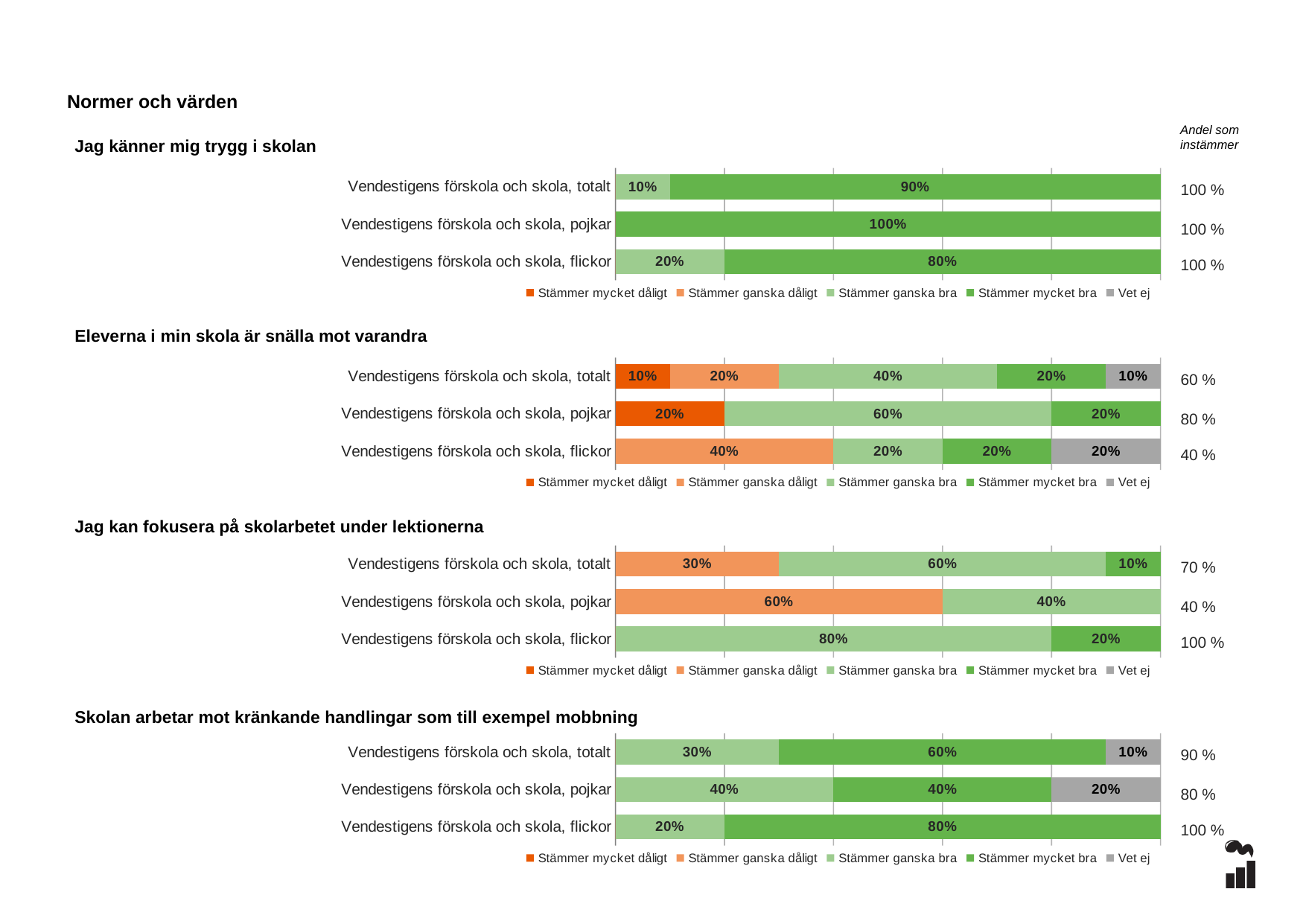
In the chart 'Skolan arbetar mot kränkande handlingar som till exempel mobbning', which is larger: the 'Stämmer mycket bra' value for totalt or for pojkar? totalt In the chart 'Jag kan fokusera på skolarbetet under lektionerna', what is the 'Stämmer ganska dåligt' value for Vendestigens förskola och skola, pojkar? 60% In the chart 'Jag kan fokusera på skolarbetet under lektionerna', what is the difference between the 'Stämmer ganska bra' values for flickor and pojkar? 40% In the chart 'Eleverna i min skola är snälla mot varandra', what is the 'Vet ej' value for Vendestigens förskola och skola, totalt? 10% How many series does the legend list for the chart 'Jag känner mig trygg i skolan'? 5 In the chart 'Eleverna i min skola är snälla mot varandra', which row has the lowest 'Andel som instämmer'? Vendestigens förskola och skola, flickor In the chart 'Jag kan fokusera på skolarbetet under lektionerna', what is the 'Andel som instämmer' for Vendestigens förskola och skola, totalt? 70 % What kind of chart is 'Eleverna i min skola är snälla mot varandra'? Stacked bar chart In the chart 'Jag känner mig trygg i skolan', what is the 'Stämmer mycket bra' value for Vendestigens förskola och skola, pojkar? 100% In the chart 'Eleverna i min skola är snälla mot varandra', what is the 'Stämmer ganska dåligt' value for Vendestigens förskola och skola, flickor? 40% In the chart 'Jag känner mig trygg i skolan', what is the 'Stämmer mycket bra' value for Vendestigens förskola och skola, flickor? 80% In the chart 'Skolan arbetar mot kränkande handlingar som till exempel mobbning', what is the 'Vet ej' value for Vendestigens förskola och skola, pojkar? 20%